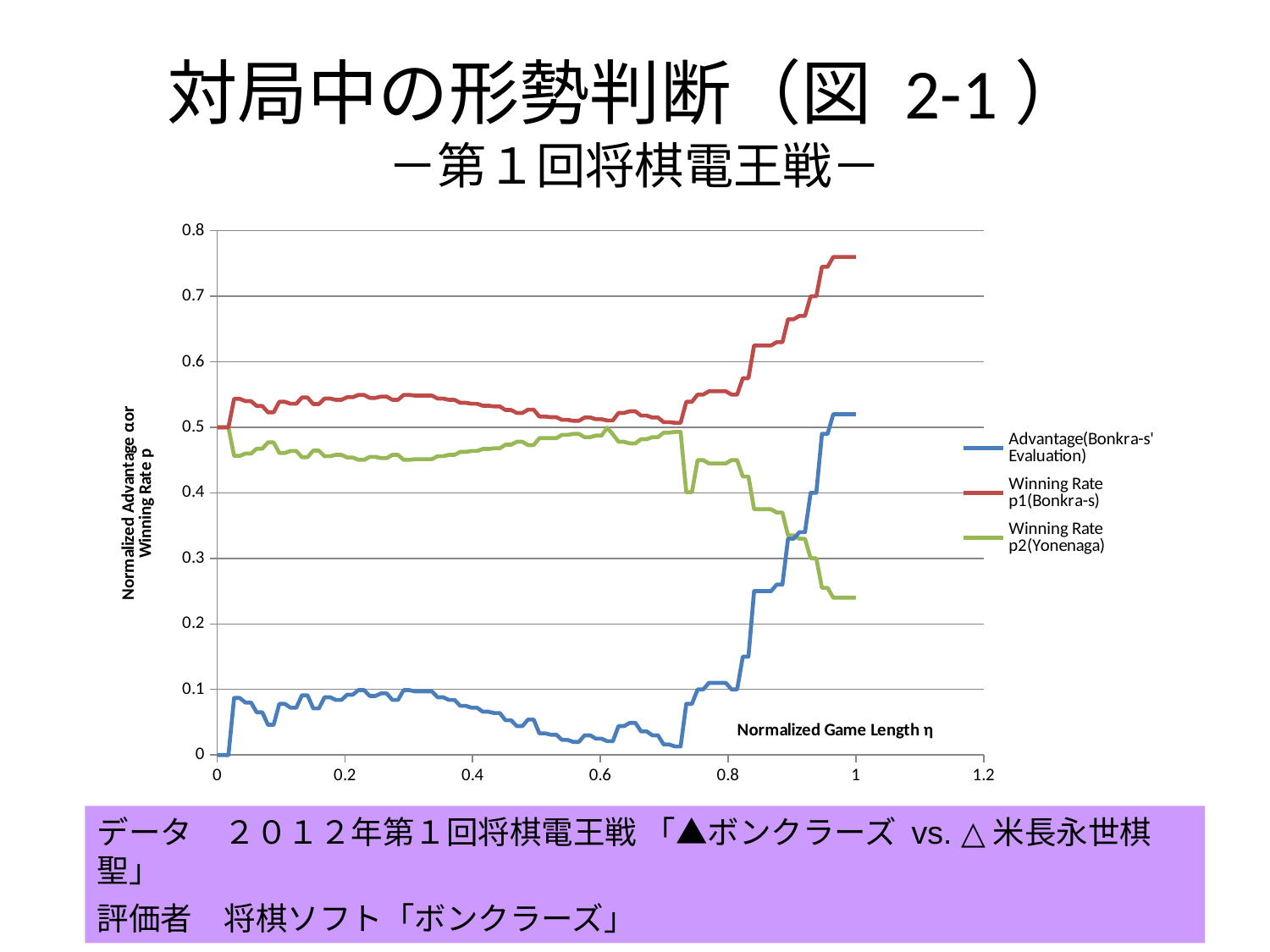
Is the value of Advantage(Bonkra-s' Evaluation) at Normalized Game Length 0.4 greater or less than 0.2? less Which series reaches the highest value anywhere on the chart? Winning Rate p1(Bonkra-s) What is the value of Advantage(Bonkra-s' Evaluation) at Normalized Game Length 0? 0 What is the value of Winning Rate p1(Bonkra-s) at Normalized Game Length 0? 0.5 What is the label of the x axis of the chart? Normalized Game Length η Does Winning Rate p2(Yonenaga) rise or fall between Normalized Game Length 0.7 and 1? fall At Normalized Game Length 1, which is larger: Winning Rate p1(Bonkra-s) or Winning Rate p2(Yonenaga)? Winning Rate p1(Bonkra-s) Is the value of Winning Rate p1(Bonkra-s) at Normalized Game Length 1 greater or less than 0.7? greater What kind of chart is shown on the slide? line chart Which series is drawn in red in the chart? Winning Rate p1(Bonkra-s) How many series does the chart legend list? 3 Is the value of Winning Rate p2(Yonenaga) at Normalized Game Length 1 greater or less than 0.3? less